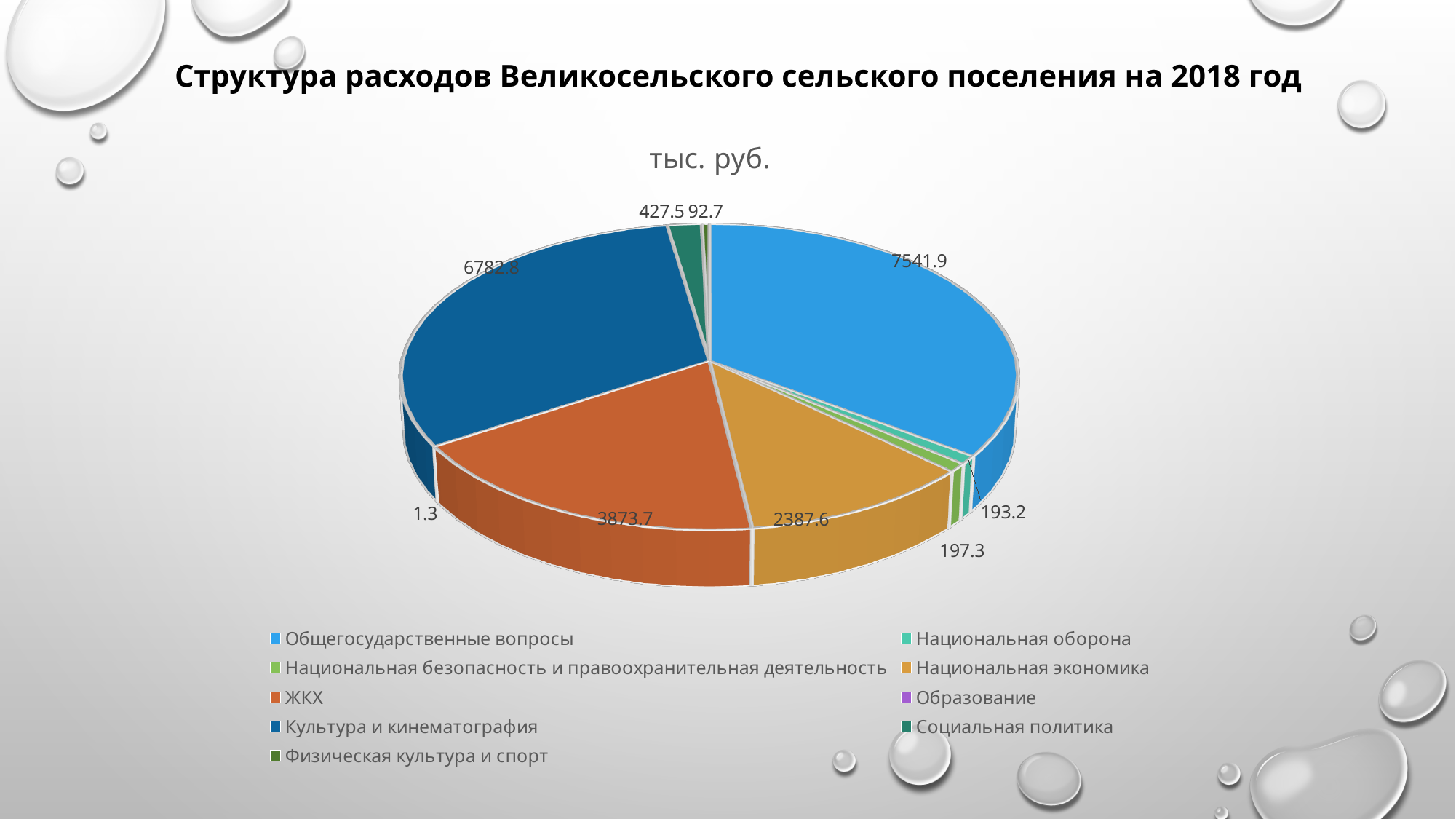
How many categories does the legend list? 9 What is the value for Культура и кинематография? 6782.8 What is the difference between the values for Общегосударственные вопросы and Культура и кинематография? 759.1 What is the title shown above the pie chart? тыс. руб. What is the value for Общегосударственные вопросы? 7541.9 Which category has the largest slice of the pie? Общегосударственные вопросы What is the value for Социальная политика? 427.5 Which is larger, ЖКХ or Национальная экономика? ЖКХ What is the value for Национальная экономика? 2387.6 What is the difference between the values for ЖКХ and Национальная экономика? 1486.1 What is the value for ЖКХ? 3873.7 What type of chart is shown on the slide? Pie chart